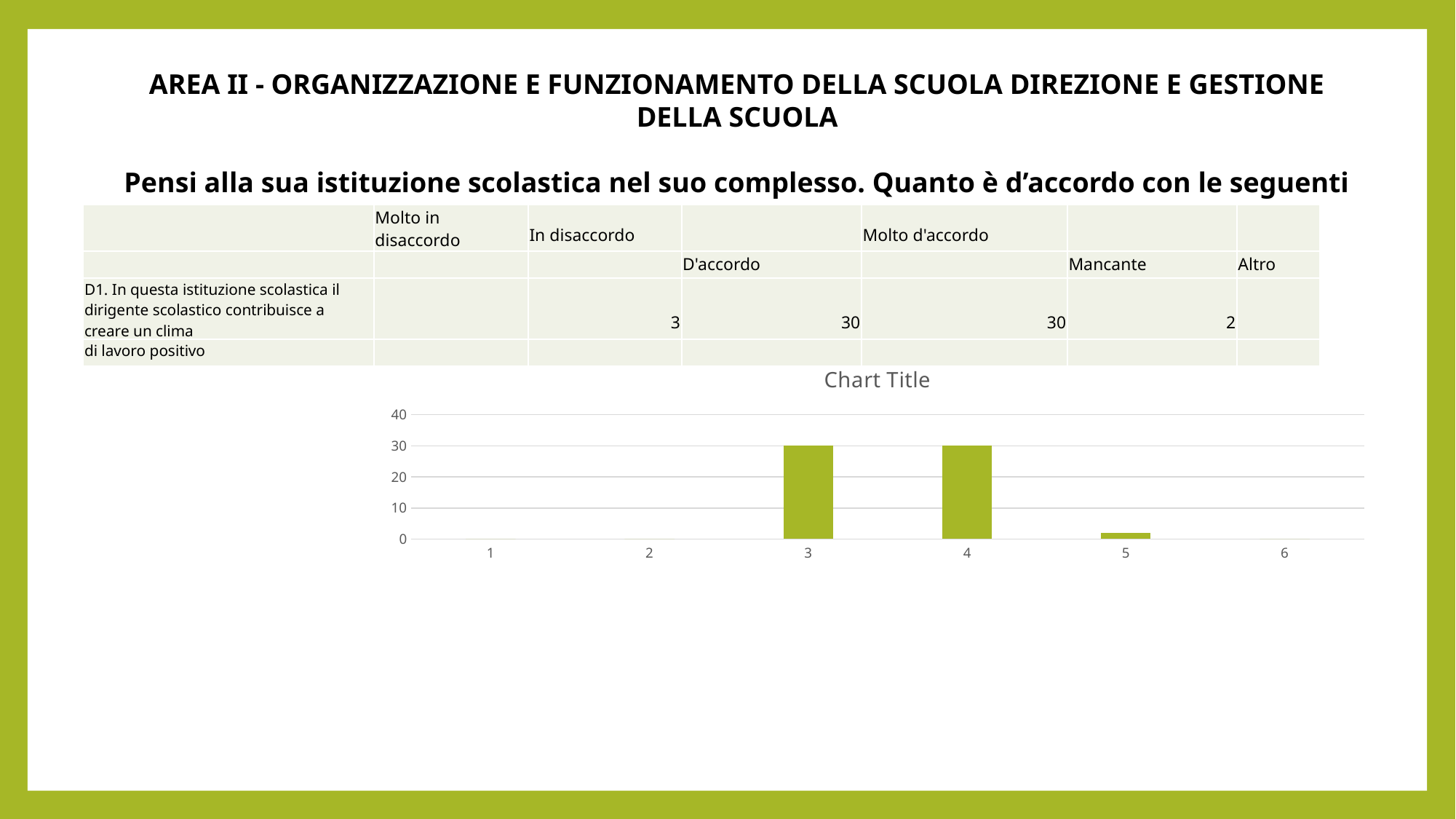
What is the value of the bar for category 4? 30 Is the value for category 3 greater or less than 20? greater What kind of chart is shown on the slide? bar chart What colour are the bars in the chart? green How many categories are shown on the x axis of the chart? 6 Is the value for category 5 greater or less than 10? less What is the value of the bar for category 3? 30 What is the title shown above the chart? Chart Title Which has the larger value, category 3 or category 5? category 3 What is the highest value shown on the chart's vertical axis? 40 Which has the larger value, category 4 or category 5? category 4 What is the difference between the values for category 3 and category 4? 0